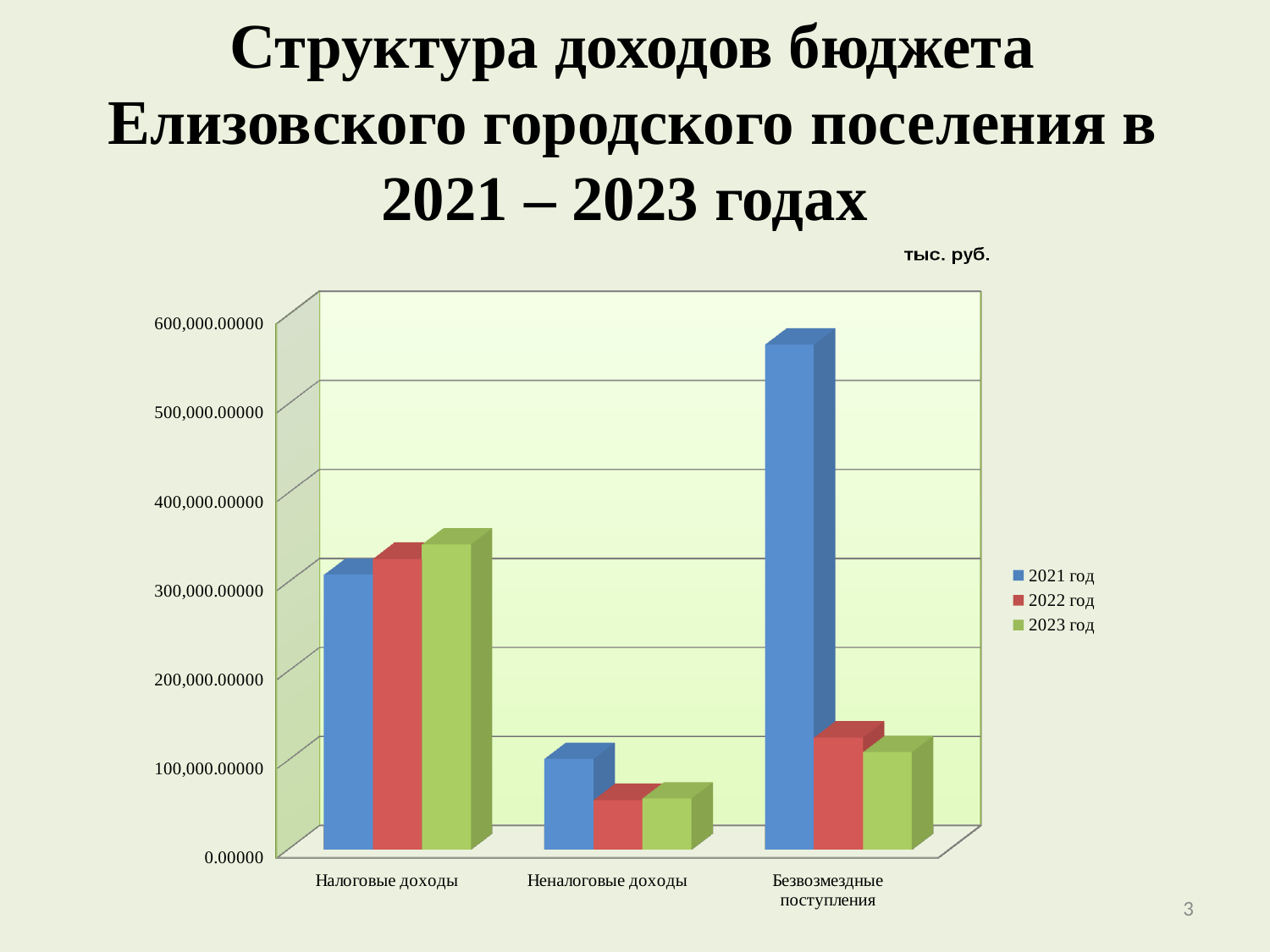
What unit is indicated above the chart? тыс. руб. Which category has the tallest bar in the chart? Безвозмездные поступления What kind of chart is shown on the slide? bar chart For the 2023 год series, which category has the highest value? Налоговые доходы Is the value for Налоговые доходы in 2023 год greater or less than 300,000.00000? greater For Безвозмездные поступления, which is larger: the 2021 год value or the 2022 год value? 2021 год Do the values for Налоговые доходы rise or fall from 2021 год to 2023 год? rise For the 2021 год series, which category has the lowest value? Неналоговые доходы How many series does the chart legend list? 3 How many categories are shown on the x axis of the chart? 3 Is the value for Безвозмездные поступления in 2021 год greater or less than 500,000.00000? greater Is the value for Неналоговые доходы in 2022 год greater or less than 100,000.00000? less